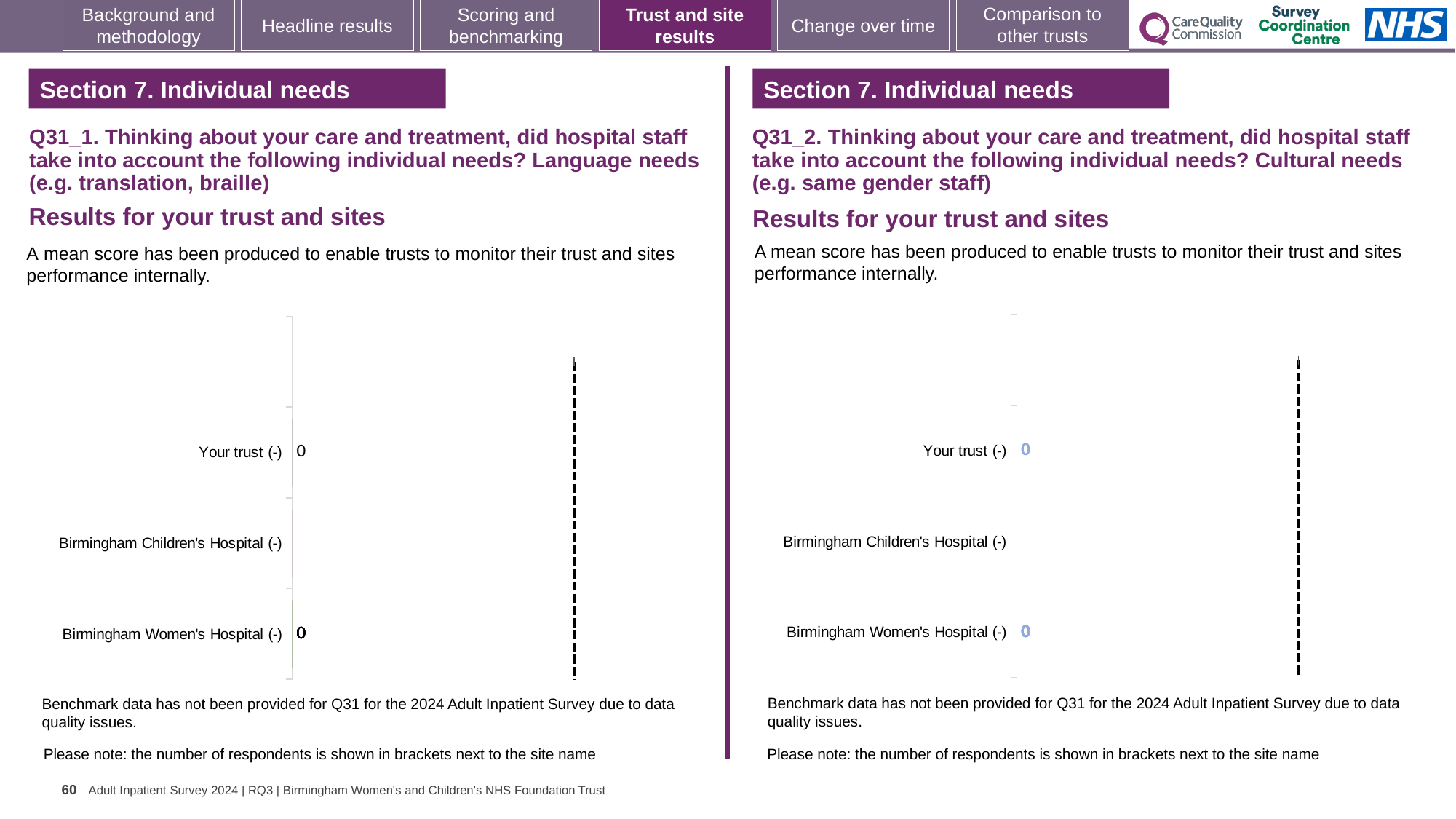
In the left chart (Q31_1, Language needs), how many categories are listed on the vertical axis? 3 In the right chart (Q31_2, Cultural needs), what value is shown for Birmingham Women's Hospital? 0 In the left chart (Q31_1, Language needs), what value is shown for Your trust? 0 In the left chart (Q31_1, Language needs), what value is shown for Birmingham Women's Hospital? 0 In the right chart (Q31_2, Cultural needs), how many categories are listed on the vertical axis? 3 In the left chart (Q31_1, Language needs), which category is listed first at the top of the axis? Your trust (-) In the left chart (Q31_1, Language needs), what is the difference between the values shown for Your trust and Birmingham Women's Hospital? 0 In the right chart (Q31_2, Cultural needs), what value is shown for Your trust? 0 In the right chart (Q31_2, Cultural needs), which category is listed last at the bottom of the axis? Birmingham Women's Hospital (-)